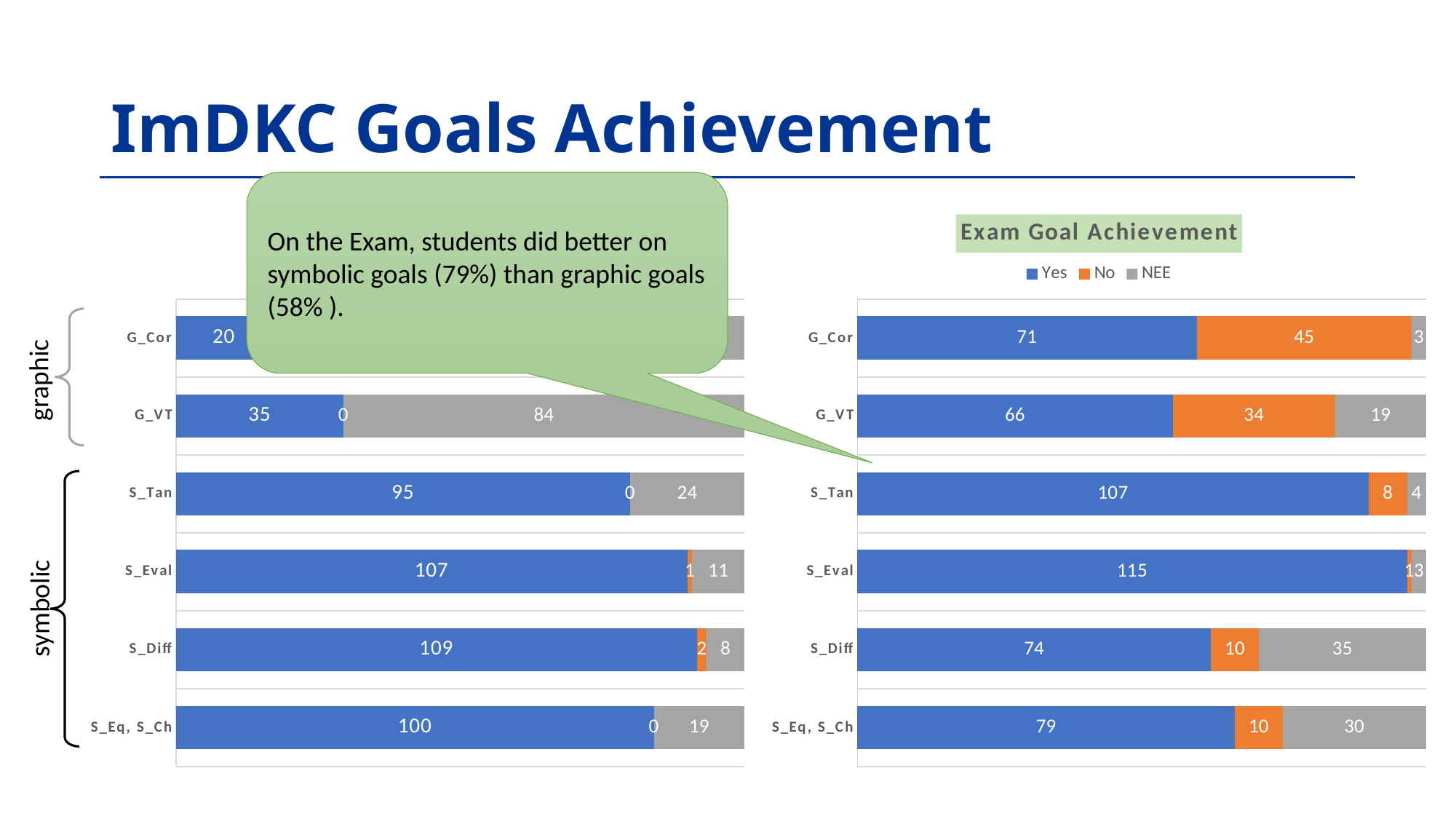
In the chart on the left, what is the blue (Yes) value for S_Diff? 109 How many categories are shown in the Exam Goal Achievement chart? 6 In the Exam Goal Achievement chart, which has the larger No value, G_Cor or G_VT? G_Cor How many series does the legend of the Exam Goal Achievement chart list? 3 In the chart on the left, what is the difference between the blue (Yes) values for S_Diff and S_Tan? 14 In the Exam Goal Achievement chart, what is the total of the stacked bar for G_Cor? 119 In the Exam Goal Achievement chart, what is the total of the stacked bar for S_Diff? 119 What kind of chart is the Exam Goal Achievement chart? Stacked bar chart In the Exam Goal Achievement chart, what is the Yes value for G_Cor? 71 In the Exam Goal Achievement chart, which category has the highest Yes value? S_Eval In the Exam Goal Achievement chart, what is the NEE value for S_Diff? 35 In the Exam Goal Achievement chart, what is the No value for G_VT? 34